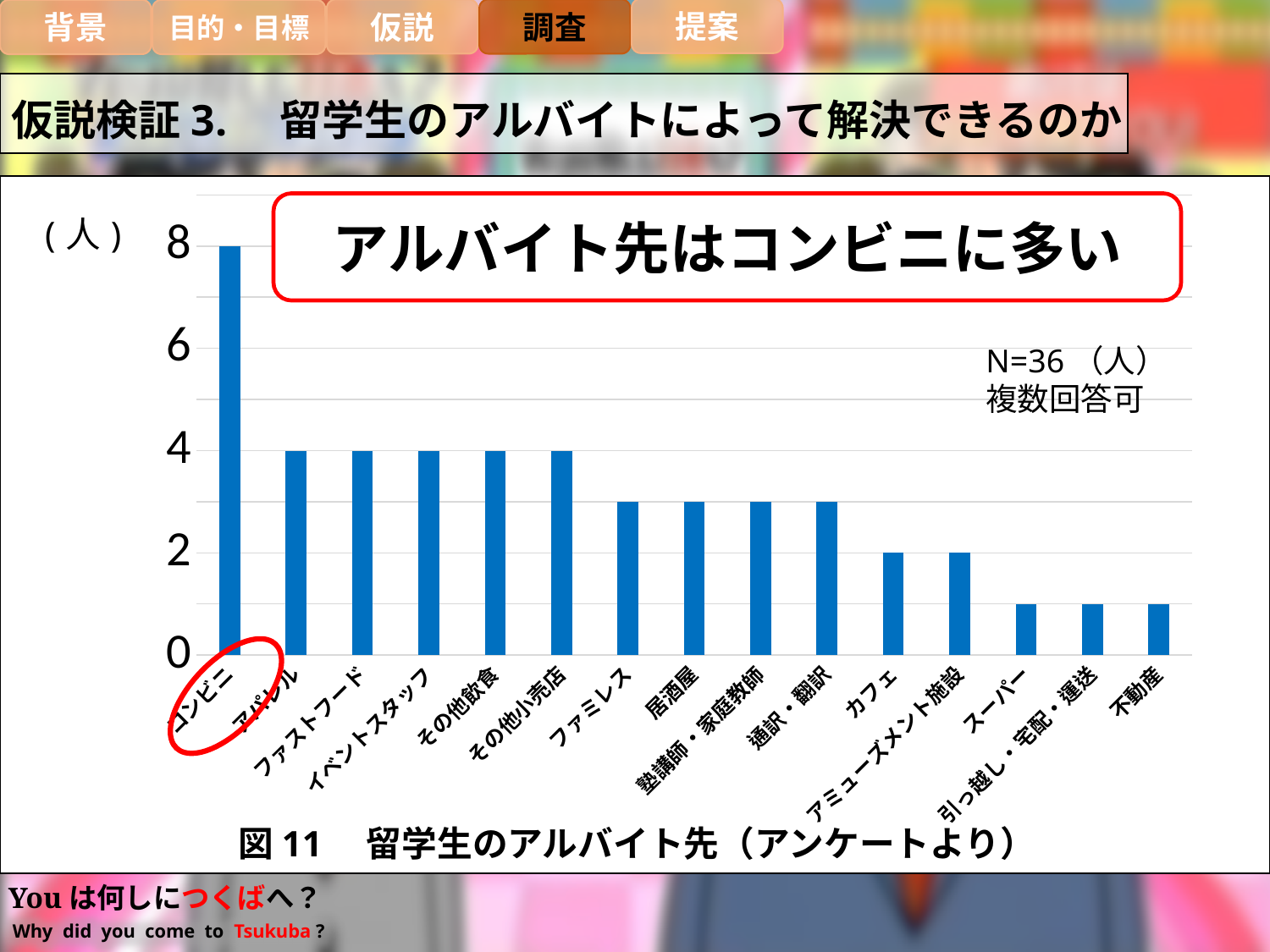
What is the sample size (N) stated on the chart? N=36 Do the values rise or fall from left to right along the x axis? fall Is the value for 不動産 greater or less than 2? less What is the difference between the values for コンビニ and ファストフード? 4 What is the value for カフェ? 2 How many categories are shown on the x axis? 15 Is the value for 居酒屋 greater or less than 2? greater Which category has the highest value? コンビニ Which is larger, the value for コンビニ or the value for カフェ? コンビニ What is the value for コンビニ? 8 What kind of chart is shown? bar chart What is the value for アパレル? 4